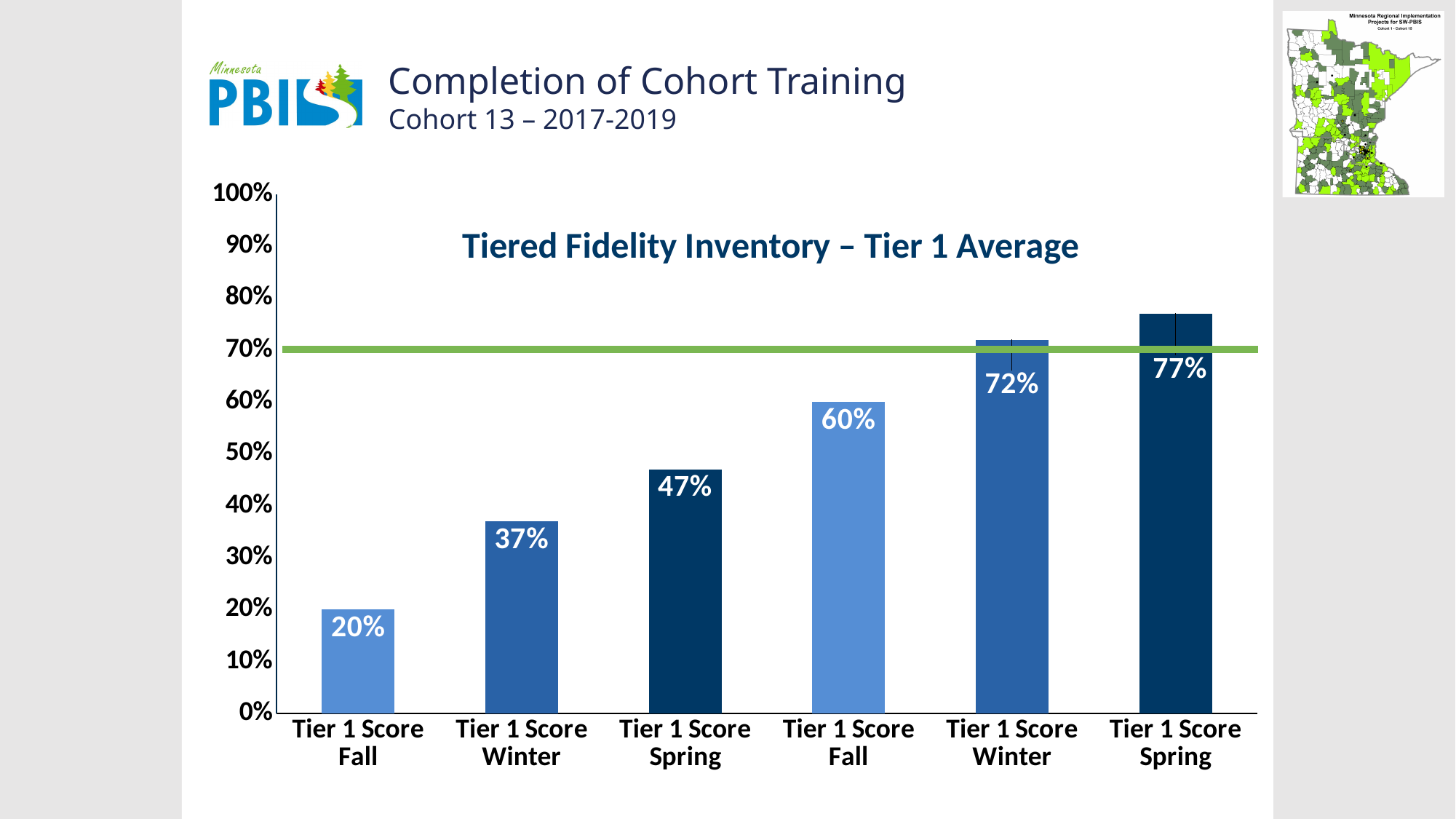
What is the value of the second bar, the first Tier 1 Score Winter? 37% What is the difference between the rightmost bar (77%) and the leftmost bar (20%)? 57% What type of chart is shown on the slide? bar chart What is the value of the fourth bar, the second Tier 1 Score Fall? 60% What is the title of the chart? Tiered Fidelity Inventory – Tier 1 Average What is the value of the third bar, the first Tier 1 Score Spring? 47% What is the value of the rightmost bar, the second Tier 1 Score Spring? 77% What is the value of the first bar, Tier 1 Score Fall (leftmost)? 20% How many bars are plotted in the chart? 6 Which bar has the highest value? Tier 1 Score Spring (rightmost bar) Which bar has the lowest value? Tier 1 Score Fall (leftmost bar) Do the values rise or fall from left to right across the bars? rise